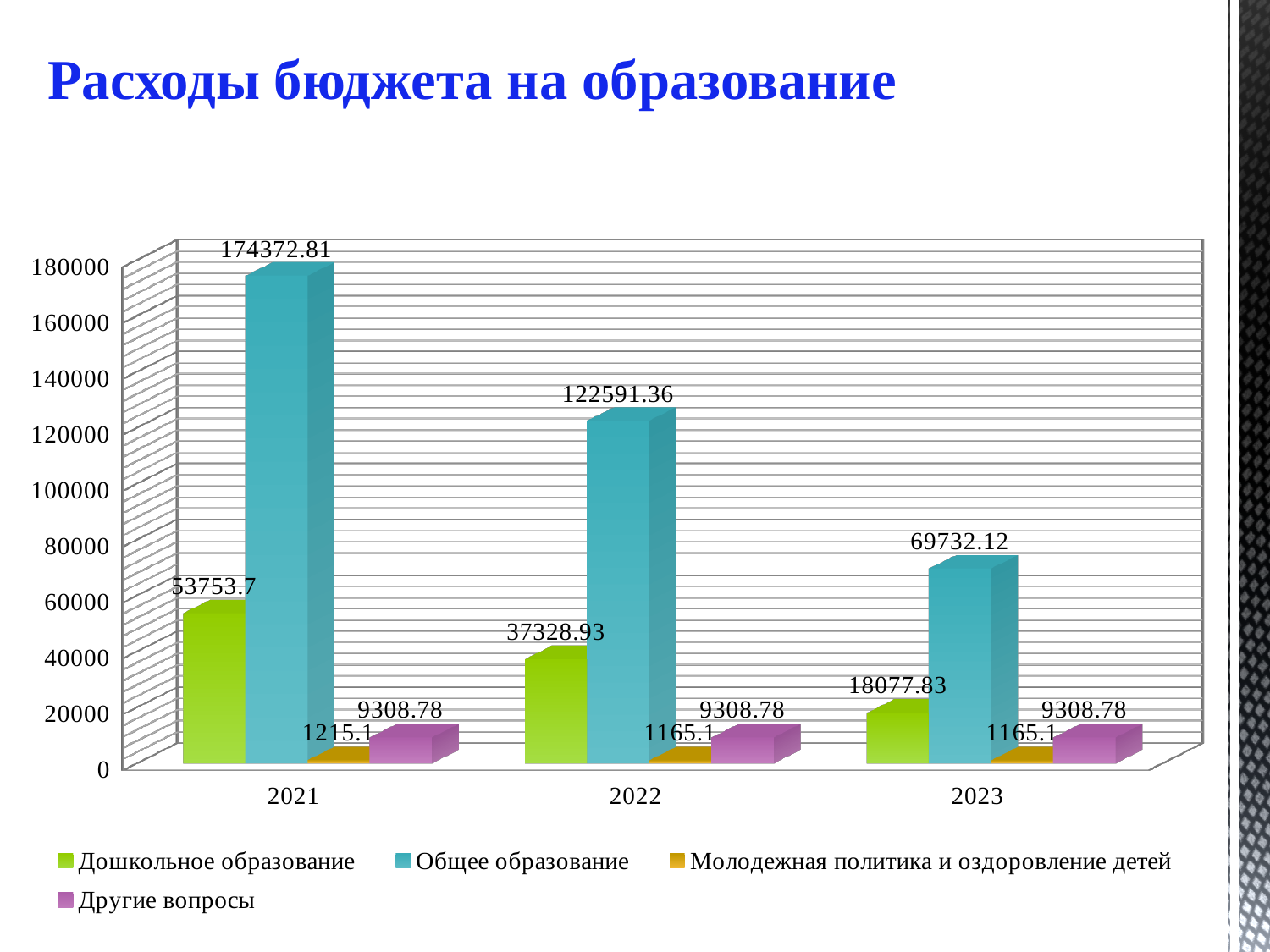
What is the value for Другие вопросы in 2023? 9308.78 How many years are shown on the x axis? 3 What kind of chart is shown on the slide? Bar chart In which year is the value for Общее образование the highest? 2021 What is the value for Общее образование in 2021? 174372.81 Which series has the lowest value in 2021? Молодежная политика и оздоровление детей Which is larger: Дошкольное образование in 2022 or Общее образование in 2023? Общее образование in 2023 How many series does the legend list? 4 What is the value for Дошкольное образование in 2023? 18077.83 What is the value for Молодежная политика и оздоровление детей in 2022? 1165.1 What is the difference between the Дошкольное образование values for 2021 and 2022? 16424.77 What is the difference between the Общее образование values for 2021 and 2022? 51781.45